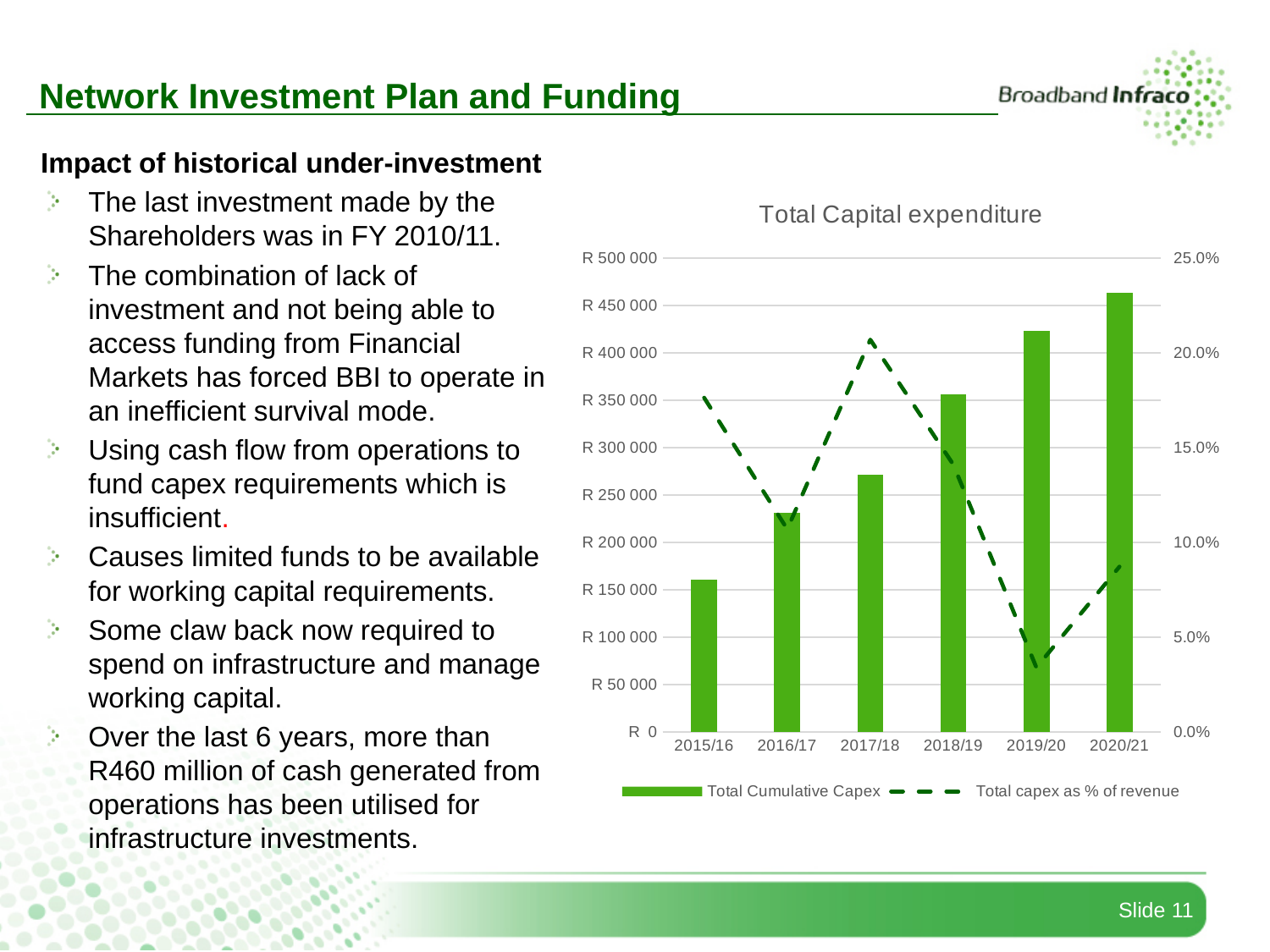
Which year has the highest Total capex as % of revenue? 2017/18 What is the title of the chart? Total Capital expenditure Is the Total capex as % of revenue for 2019/20 greater or less than 5.0%? less What type of chart is shown on the slide? Bar chart with a line Is the Total Cumulative Capex for 2015/16 greater or less than R 200 000? less Do the Total Cumulative Capex bars rise or fall from 2015/16 to 2020/21? Rise Which year has the lowest Total capex as % of revenue? 2019/20 Which year has the highest Total Cumulative Capex bar? 2020/21 Is the Total Cumulative Capex for 2018/19 greater or less than R 300 000? greater How many series does the chart legend list? 2 How many financial years are shown on the x axis of the chart? 6 Which year has the lowest Total Cumulative Capex bar? 2015/16